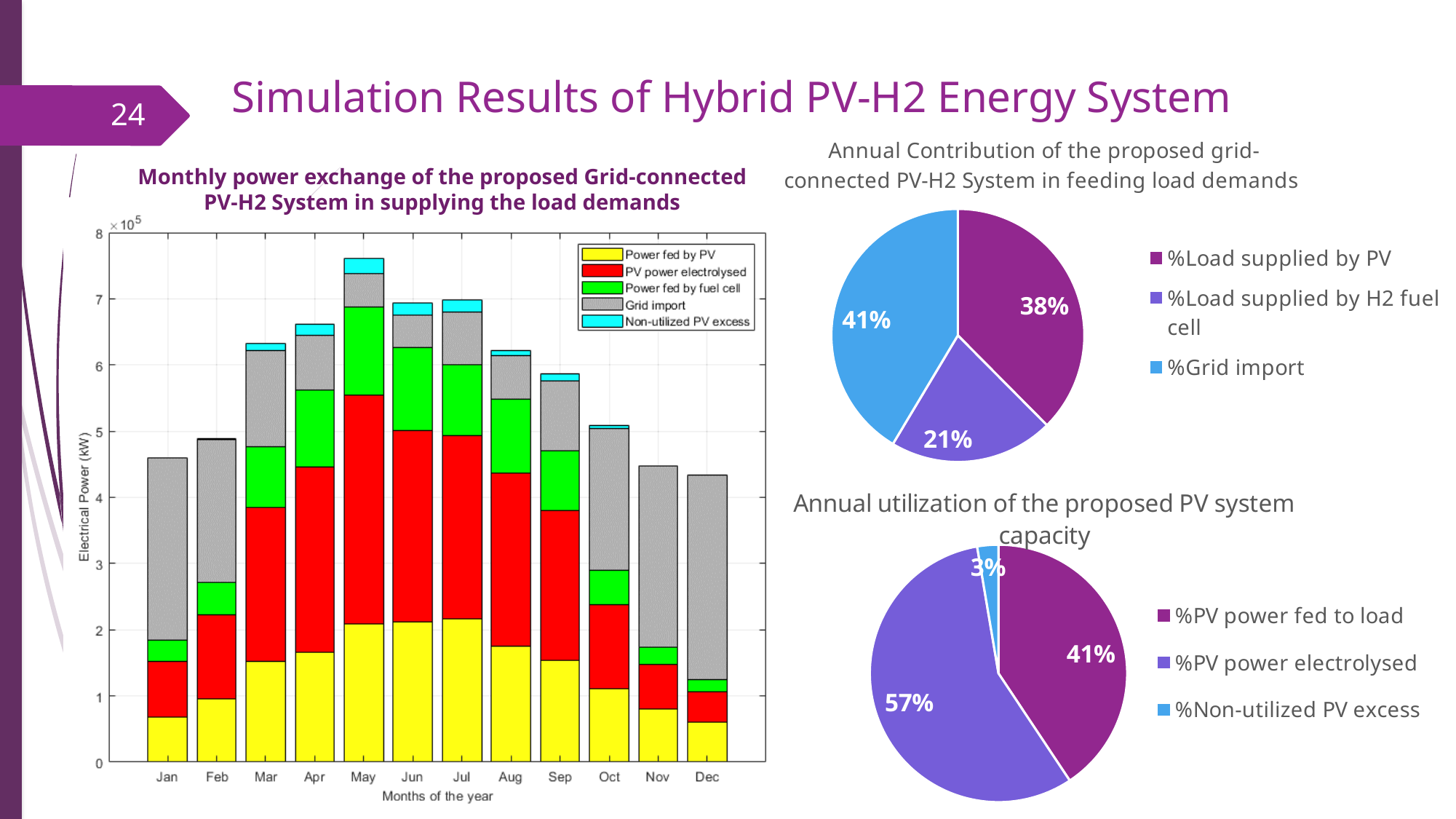
How many months (categories) are shown on the x axis of the monthly power exchange bar chart? 12 In the 'Annual Contribution of the proposed grid-connected PV-H2 System in feeding load demands' pie chart, what is the share of %Load supplied by H2 fuel cell? 21% In the 'Annual utilization of the proposed PV system capacity' pie chart, which category has the smallest share? %Non-utilized PV excess In the monthly power exchange bar chart, is the total bar for May greater or less than 7 (×10^5 kW)? greater In the 'Annual utilization of the proposed PV system capacity' pie chart, what is the share of %PV power electrolysed? 57% In the 'Annual Contribution' pie chart, what is the difference between the %Grid import share and the %Load supplied by PV share? 3 percentage points What kind of chart is the 'Monthly power exchange of the proposed Grid-connected PV-H2 System' chart? Stacked bar chart In the 'Annual Contribution' pie chart, which category has the largest share? %Grid import In the monthly power exchange bar chart, is the total bar for Jan greater or less than 5 (×10^5 kW)? less In the monthly power exchange bar chart, which month has the highest total stacked bar? May In the monthly power exchange bar chart, which series is shown in yellow? Power fed by PV How many series does the legend of the monthly power exchange bar chart list? 5